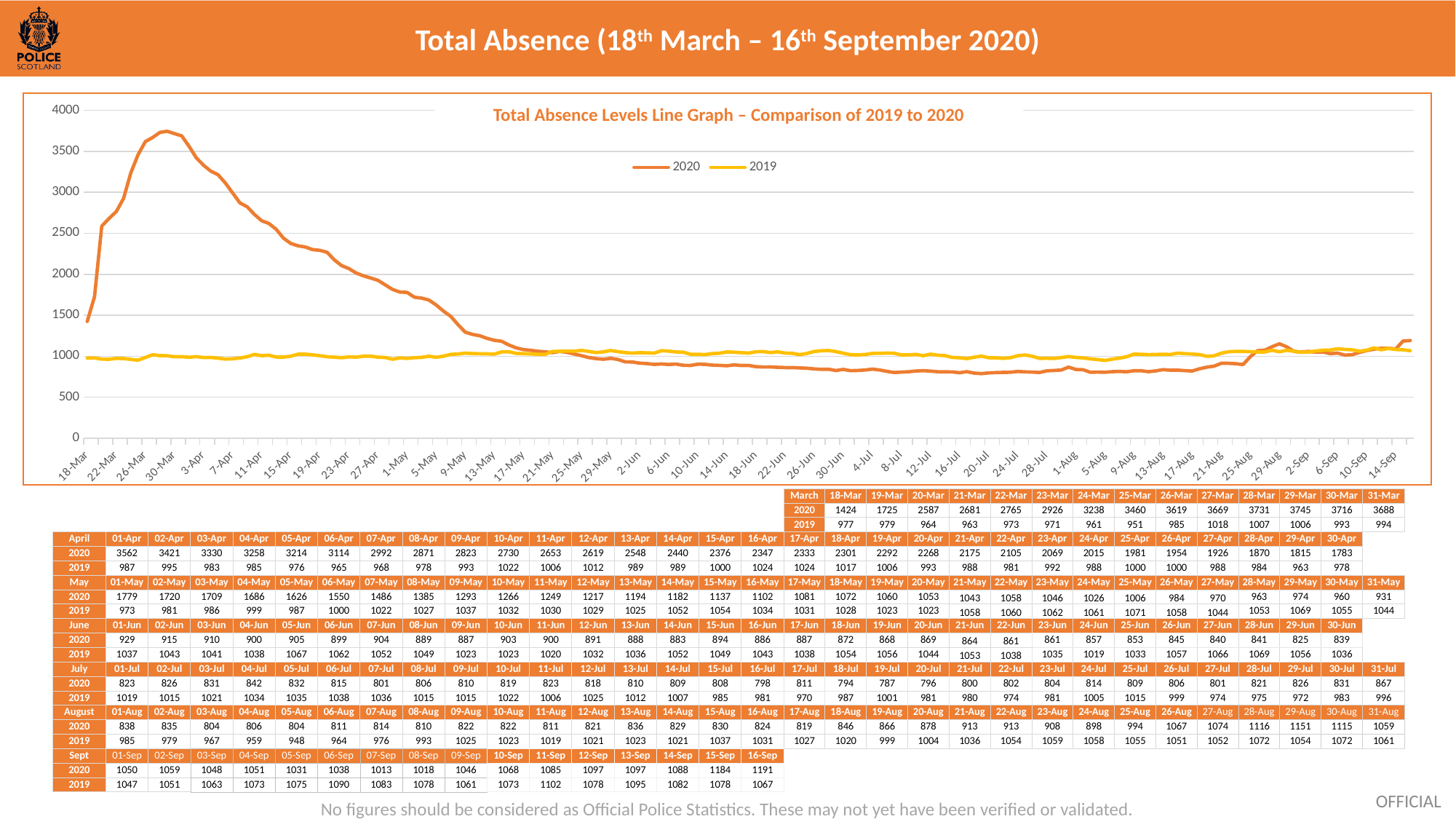
Does the 2020 line rise or fall between 30-Mar and 13-May? Falls On 01-Jul, which series has the higher value, 2020 or 2019? 2019 Which colour represents the 2019 series in the line graph? Yellow What type of chart is shown on the slide? Line chart Is the 2020 value on 30-Mar greater or less than 3500? greater What was the total absence value for 2019 on 18-Mar? 977 How many series does the legend of the line graph list? 2 On which date did the 2020 series reach its highest value? 29-Mar What was the total absence value for 2020 on 18-Mar? 1424 What is the difference between the 2020 and 2019 values on 16-Sep? 124 What was the total absence value for 2020 on 16-Sep? 1191 What is the difference between the 2020 and 2019 values on 18-Mar? 447